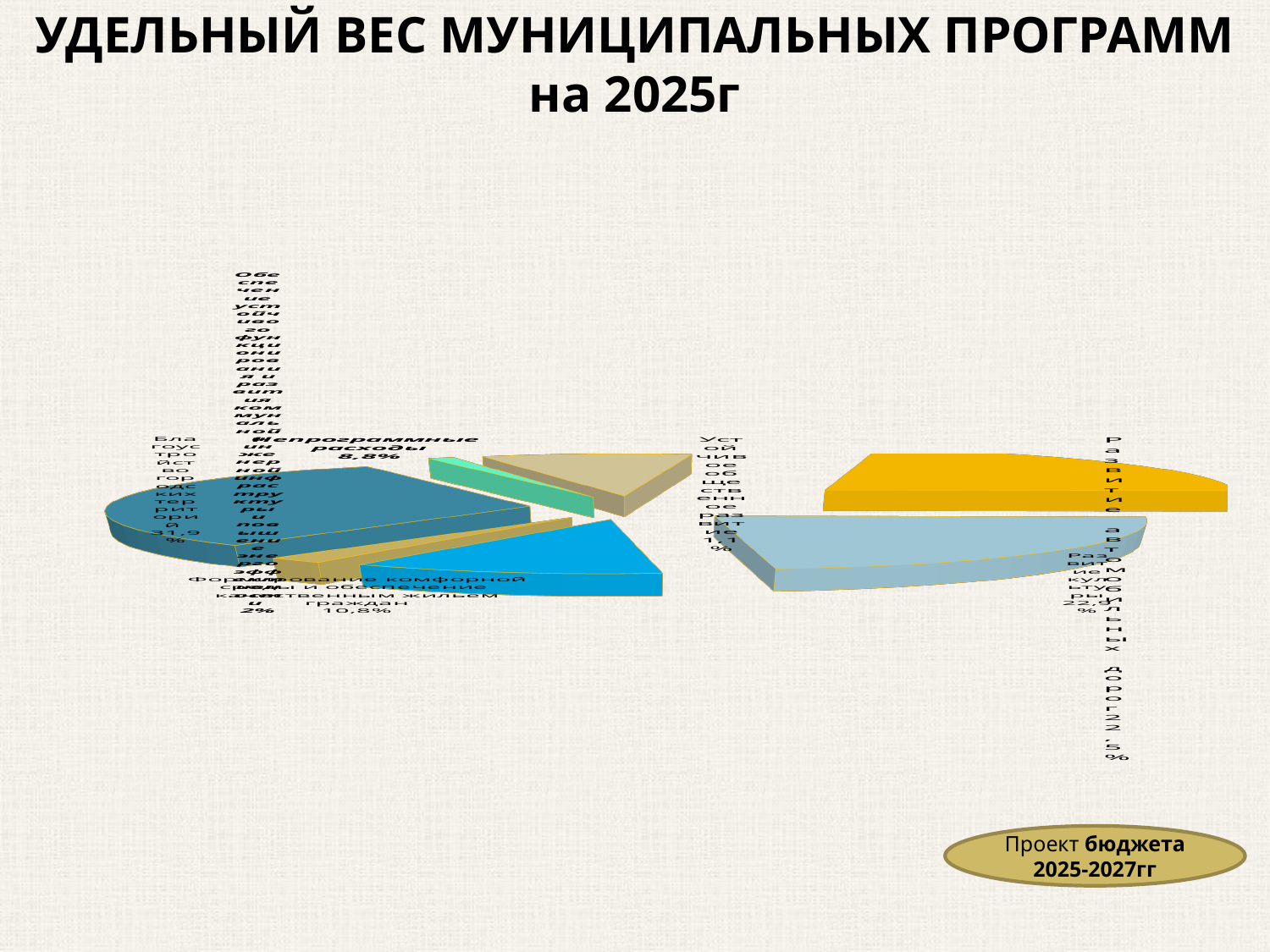
Is the share for Развитие автомобильных дорог greater or less than 20%? greater What is the title of the slide's chart? УДЕЛЬНЫЙ ВЕС МУНИЦИПАЛЬНЫХ ПРОГРАММ на 2025г What share is shown for Развитие автомобильных дорог? 22,5% What share is shown for Непрограммные расходы? 8,8% What kind of chart is shown on the slide? pie chart Is the share for Непрограммные расходы greater or less than 10%? less How many slices does the pie chart have? 7 What share is shown for Формирование комфортной среды и обеспечение качественным жильем граждан? 10,8% Which has the larger share: Развитие автомобильных дорог or Непрограммные расходы? Развитие автомобильных дорог Which has the larger share: Непрограммные расходы or Формирование комфортной среды и обеспечение качественным жильем граждан? Формирование комфортной среды и обеспечение качественным жильем граждан